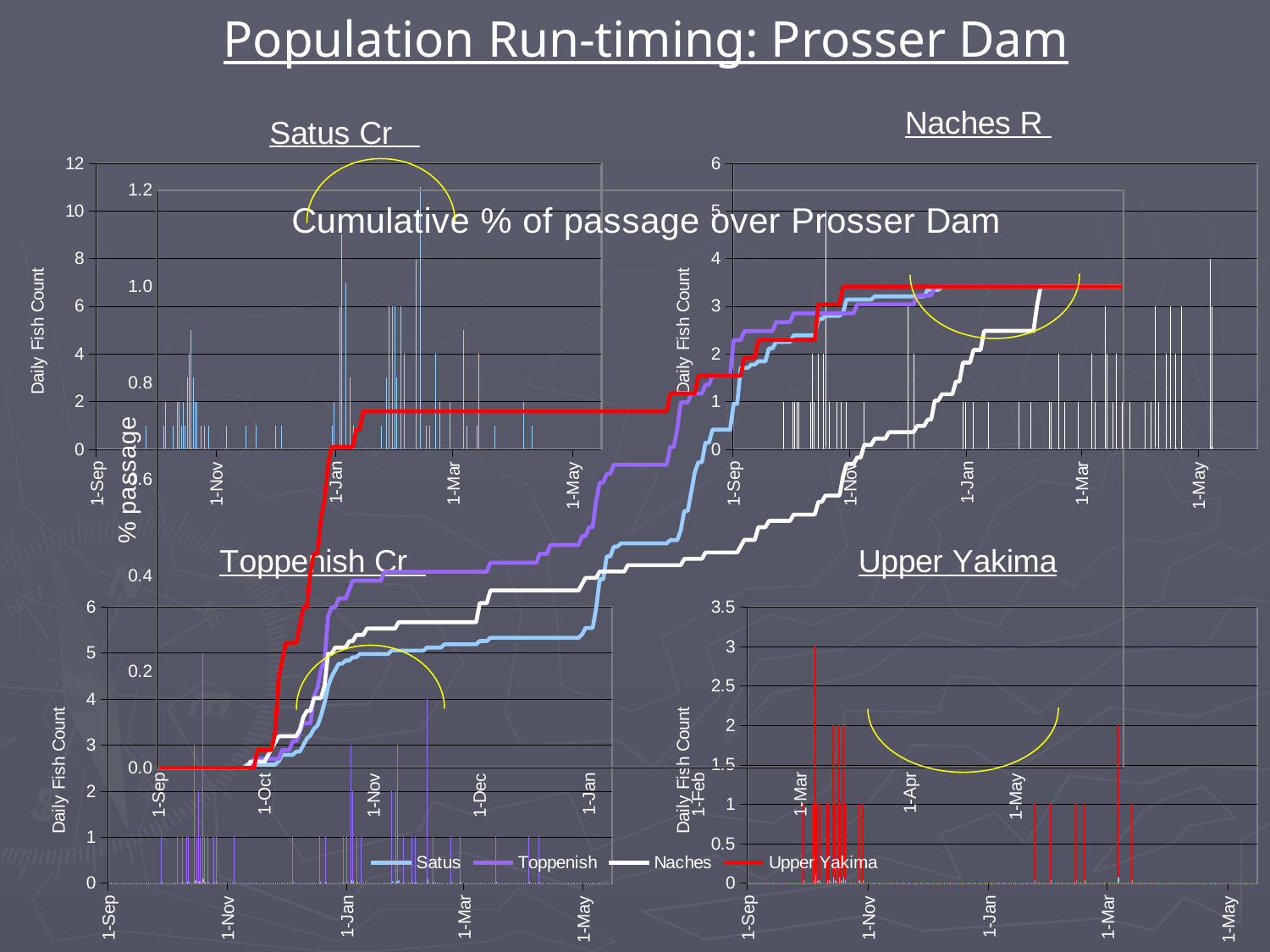
What is the highest value shown on the y axis of the 'Upper Yakima' chart? 3.5 What is the highest value shown on the y axis of the 'Satus Cr' chart? 12 What is the y-axis label of the 'Naches R' chart? Daily Fish Count What are the legend entries of the 'Cumulative % of passage over Prosser Dam' chart? Satus, Toppenish, Naches, Upper Yakima How many series does the legend of the 'Cumulative % of passage over Prosser Dam' chart list? 4 What kind of chart is the 'Cumulative % of passage over Prosser Dam' chart? line chart In the 'Satus Cr' chart, is the tallest bar greater or less than 8? greater What kind of chart is the 'Satus Cr' chart? bar chart In the 'Upper Yakima' chart, is the tallest bar greater or less than 2.5? greater In the 'Cumulative % of passage over Prosser Dam' chart, do the series values rise or fall along the x axis? rise In the 'Cumulative % of passage over Prosser Dam' chart, which series is the first to reach 1.0? Upper Yakima What colour is the Upper Yakima line in the 'Cumulative % of passage over Prosser Dam' chart? red